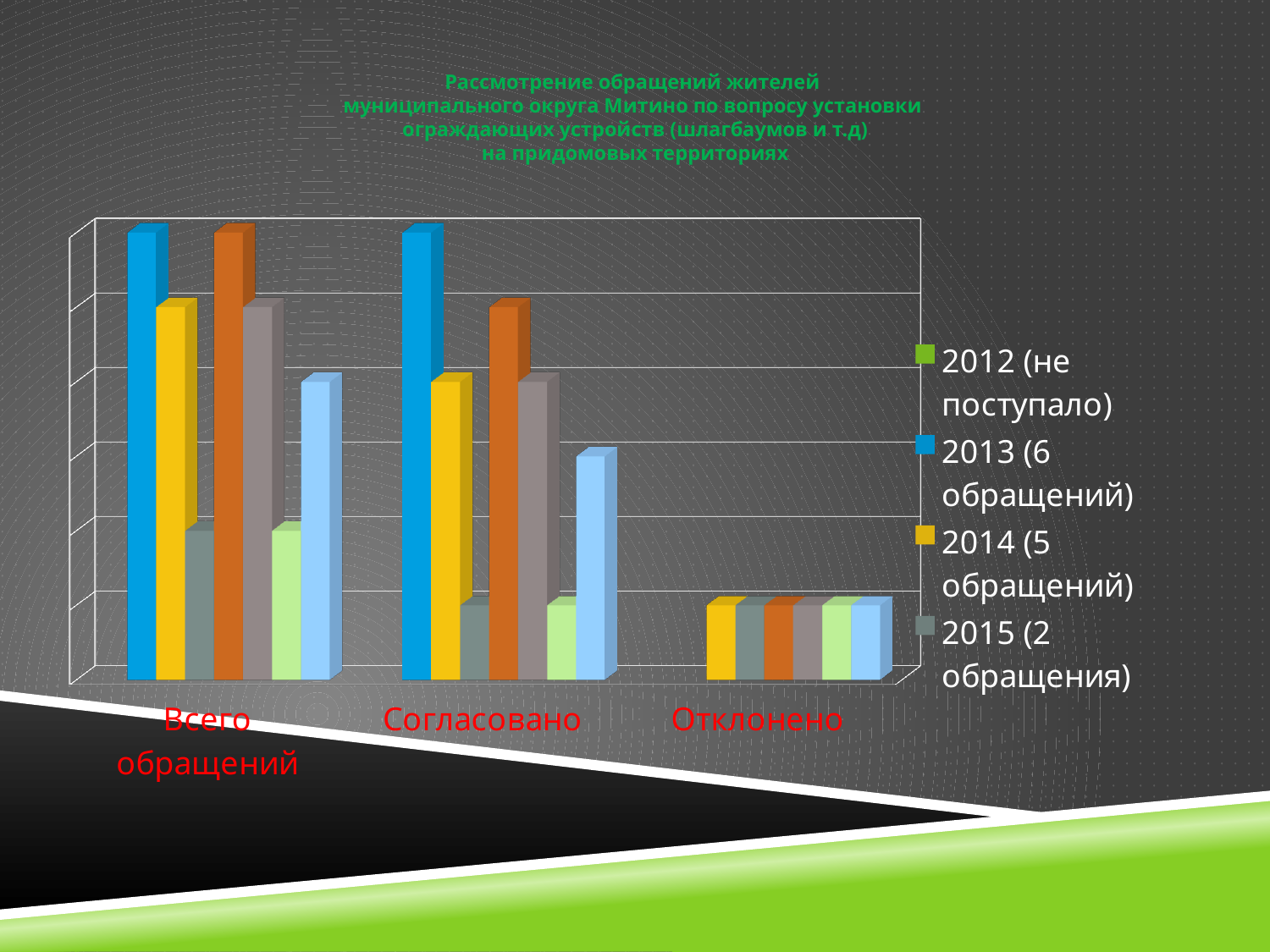
Do the bars for the series 2013 (6 обращений) rise or fall moving from 'Всего обращений' to 'Отклонено' along the x axis? fall How many categories are shown on the x axis of the chart? 3 Which category has the lowest bars in the chart? Отклонено What kind of chart is shown on the slide? bar chart For the series 2013 (6 обращений), which category has the larger bar: 'Всего обращений' or 'Отклонено'? Всего обращений According to the legend, what is noted for the year 2012? не поступало According to the legend, how many appeals were received in 2014? 5 обращений In the category 'Согласовано', which is larger: the bar for 2014 (5 обращений) or the bar for 2015 (2 обращения)? 2014 (5 обращений) In the category 'Всего обращений', is the bar for 2013 (6 обращений) taller or shorter than the bar for 2014 (5 обращений)? taller